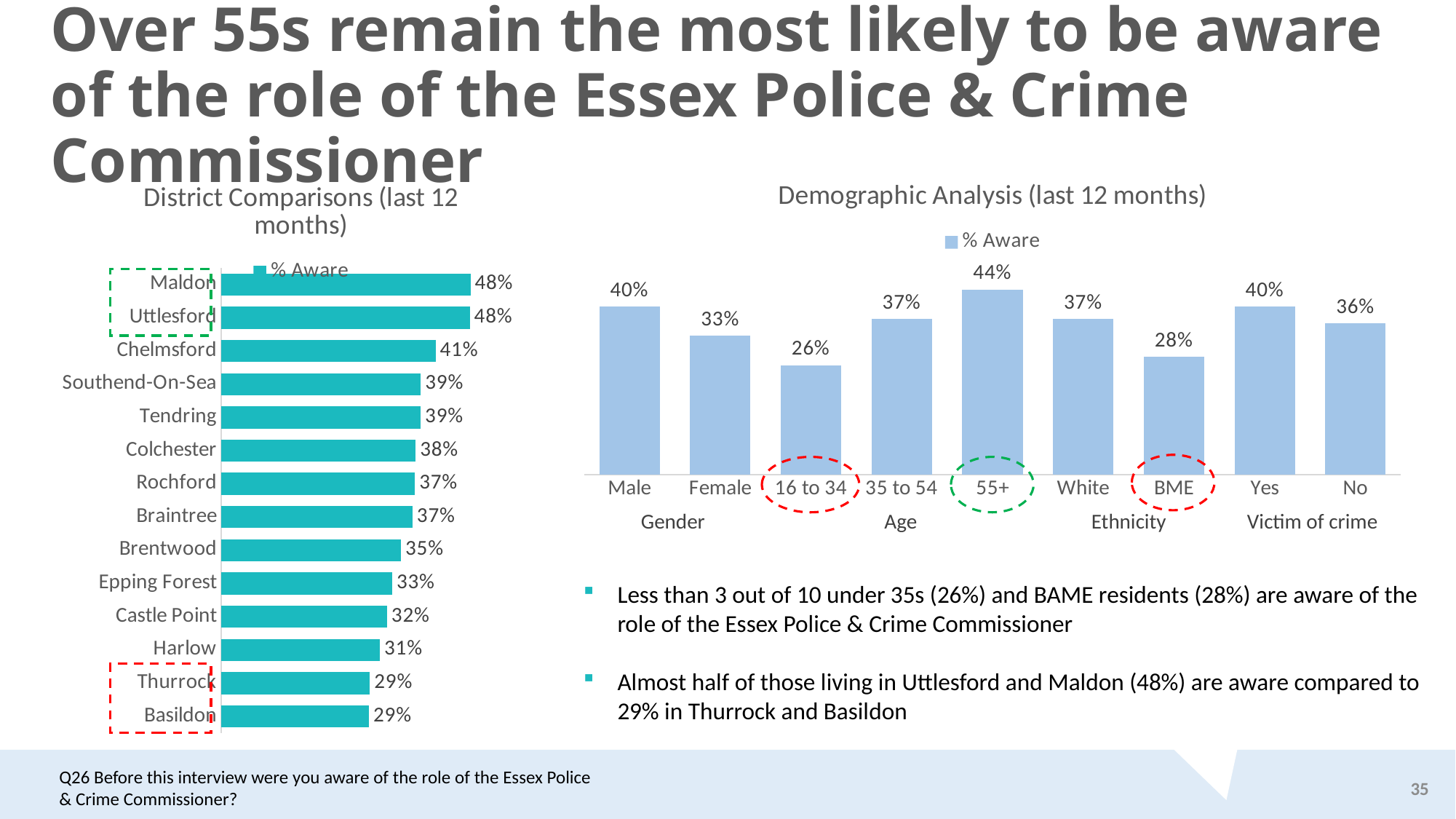
In the District Comparisons chart, which has a higher % Aware value, Brentwood or Castle Point? Brentwood In the District Comparisons chart, what is the % Aware value for Harlow? 31% In the District Comparisons chart, what is the difference in % Aware between Maldon and Basildon? 19% In the Demographic Analysis chart, what is the % Aware value for 55+? 44% In the District Comparisons chart, what is the % Aware value for Chelmsford? 41% How many districts are shown in the District Comparisons chart? 14 How many categories are plotted in the Demographic Analysis chart? 9 In the Demographic Analysis chart, which category has the lowest % Aware value? 16 to 34 What type of chart is the District Comparisons chart? Bar chart In the Demographic Analysis chart, what is the difference in % Aware between Male and Female? 7% In the Demographic Analysis chart, which category has the highest % Aware value? 55+ In the Demographic Analysis chart, what is the % Aware value for BME? 28%